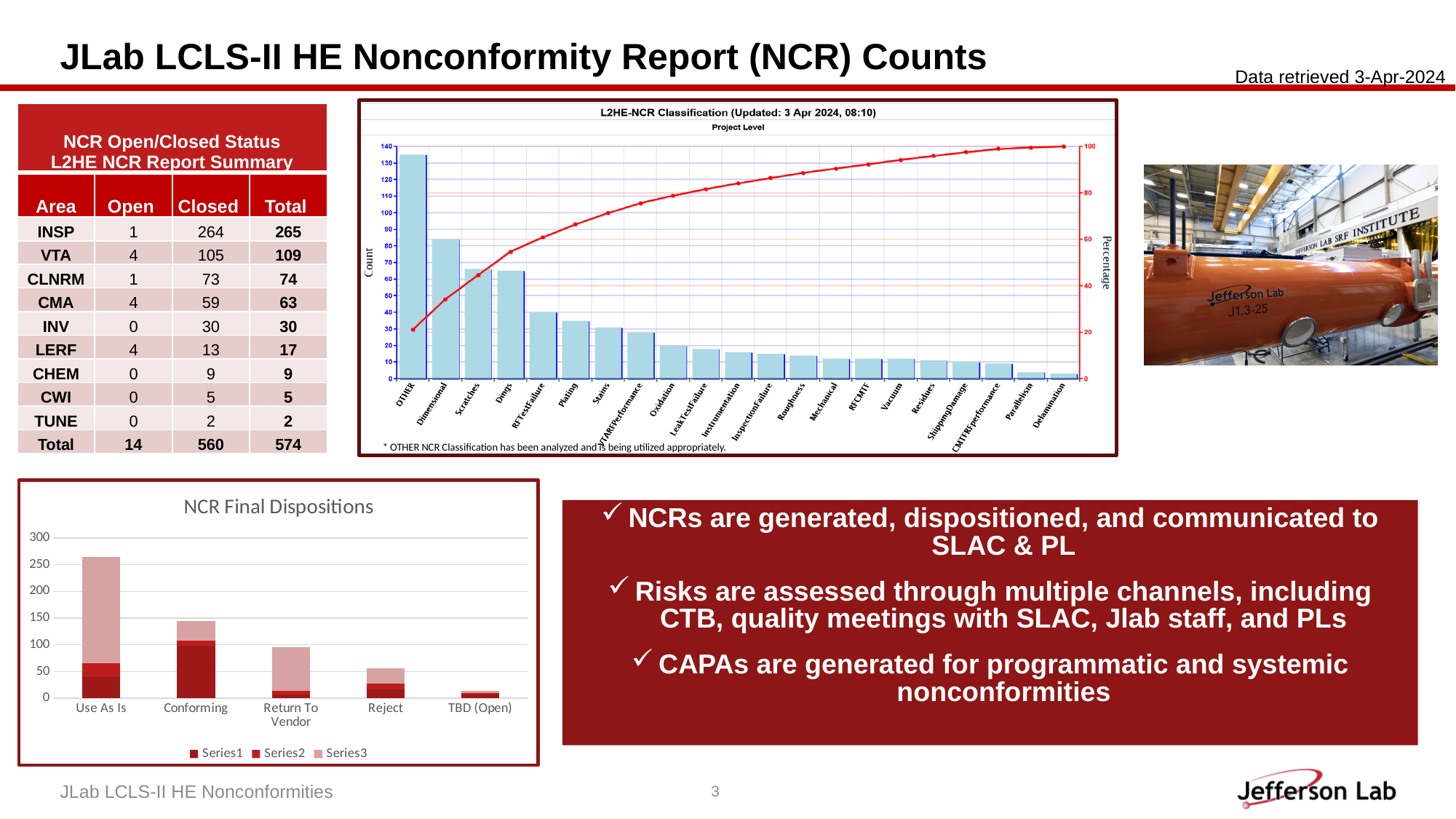
In the 'L2HE-NCR Classification' chart, do the bar counts rise or fall from left to right along the x axis? fall In the 'L2HE-NCR Classification' chart, which has the higher count, Dimensional or Scratches? Dimensional In the 'NCR Final Dispositions' chart, which category has the shortest stacked bar? TBD (Open) In the 'L2HE-NCR Classification' chart, which classification has the highest count? OTHER How many series does the legend of the 'NCR Final Dispositions' chart list? 3 How many categories are shown on the x axis of the 'NCR Final Dispositions' chart? 5 In the 'NCR Final Dispositions' chart, which has the taller stacked bar, Return To Vendor or Reject? Return To Vendor What kind of chart is the 'NCR Final Dispositions' chart? stacked bar chart In the 'L2HE-NCR Classification' chart, is the count for OTHER greater or less than 120? greater In the 'NCR Final Dispositions' chart, is the total stacked bar for Use As Is greater or less than 250? greater In the 'NCR Final Dispositions' chart, which category has the tallest stacked bar? Use As Is